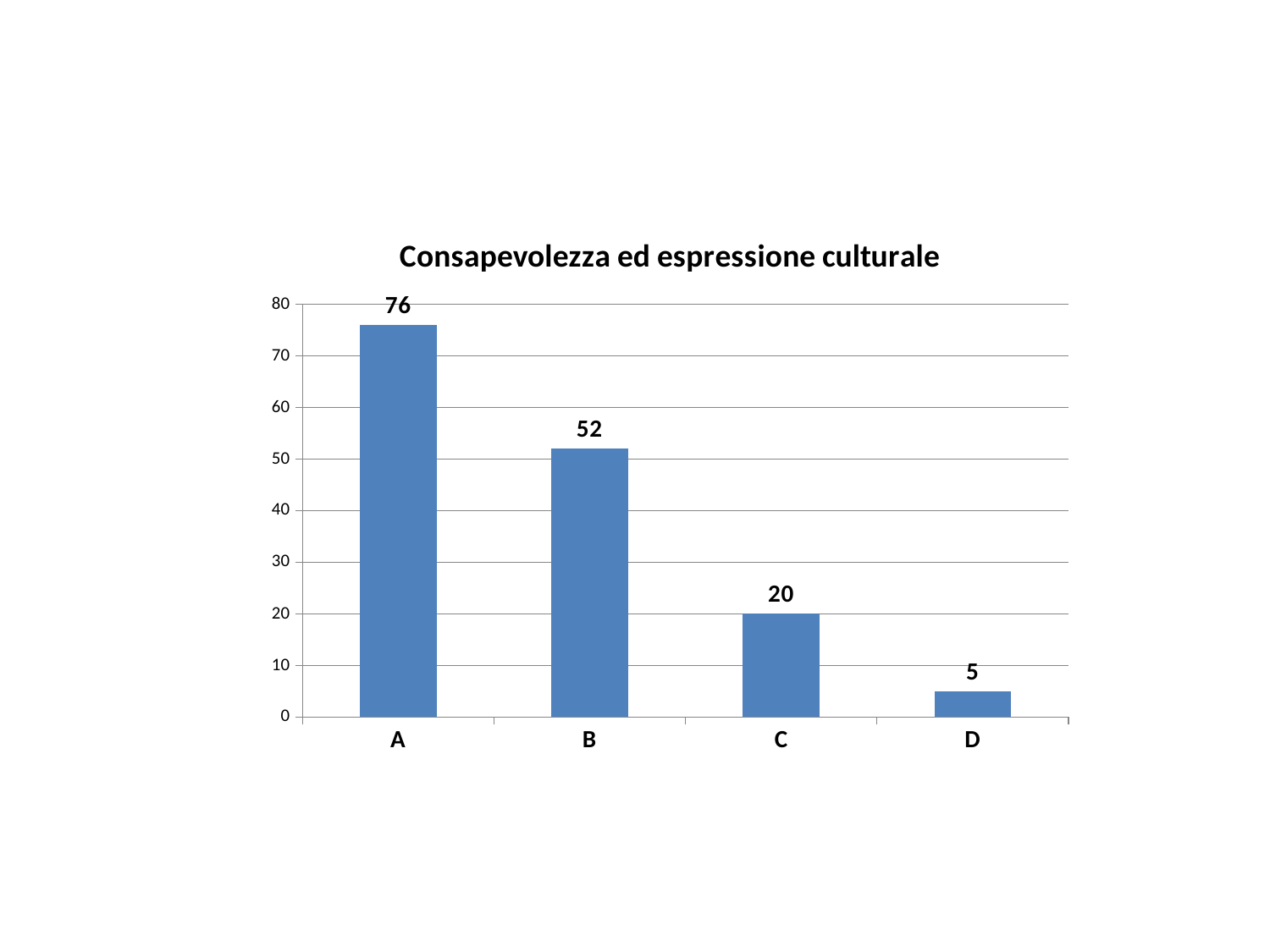
What is the difference between the values for A and B? 24 What is the value for category A? 76 Which category has the highest value? A Which is larger, the value for C or the value for D? C What is the value for category C? 20 What is the value for category D? 5 How many categories are shown on the x axis? 4 What is the value for category B? 52 Is the value for B greater or less than 50? greater What kind of chart is shown on the slide? Bar chart What is the title of the chart? Consapevolezza ed espressione culturale Which category has the lowest value? D